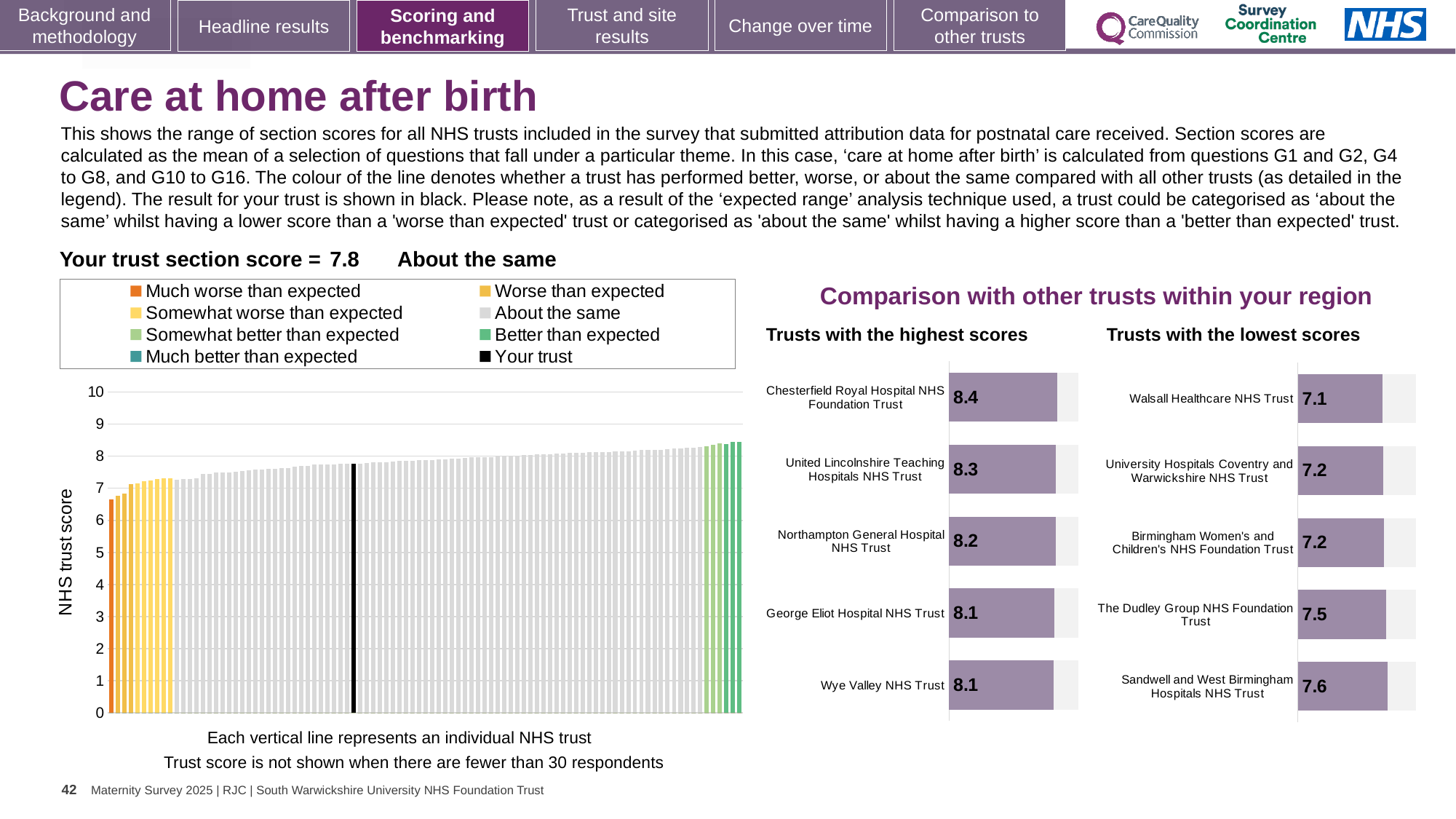
In the main 'NHS trust score' chart on the left, is the value for the leftmost trust bar greater or less than 7? less How many trusts are shown in the 'Trusts with the lowest scores' chart? 5 What kind of chart is the main 'NHS trust score' chart on the left? bar chart In the main 'NHS trust score' chart on the left, is the value for the black 'Your trust' bar greater or less than 7? greater In the 'Trusts with the highest scores' chart, what is the score for Chesterfield Royal Hospital NHS Foundation Trust? 8.4 In the 'Trusts with the highest scores' chart, which trust has the highest score? Chesterfield Royal Hospital NHS Foundation Trust In the 'Trusts with the highest scores' chart, what is the difference between the scores for Chesterfield Royal Hospital NHS Foundation Trust and Wye Valley NHS Trust? 0.3 In the 'Trusts with the lowest scores' chart, which trust has the lowest score? Walsall Healthcare NHS Trust Which is larger: the score for Northampton General Hospital NHS Trust in the 'Trusts with the highest scores' chart or the score for The Dudley Group NHS Foundation Trust in the 'Trusts with the lowest scores' chart? Northampton General Hospital NHS Trust What is the difference between the score for Chesterfield Royal Hospital NHS Foundation Trust in the 'Trusts with the highest scores' chart and the score for Walsall Healthcare NHS Trust in the 'Trusts with the lowest scores' chart? 1.3 In the main 'NHS trust score' chart on the left, do the values rise or fall from left to right? rise In the 'Trusts with the lowest scores' chart, what is the score for The Dudley Group NHS Foundation Trust? 7.5